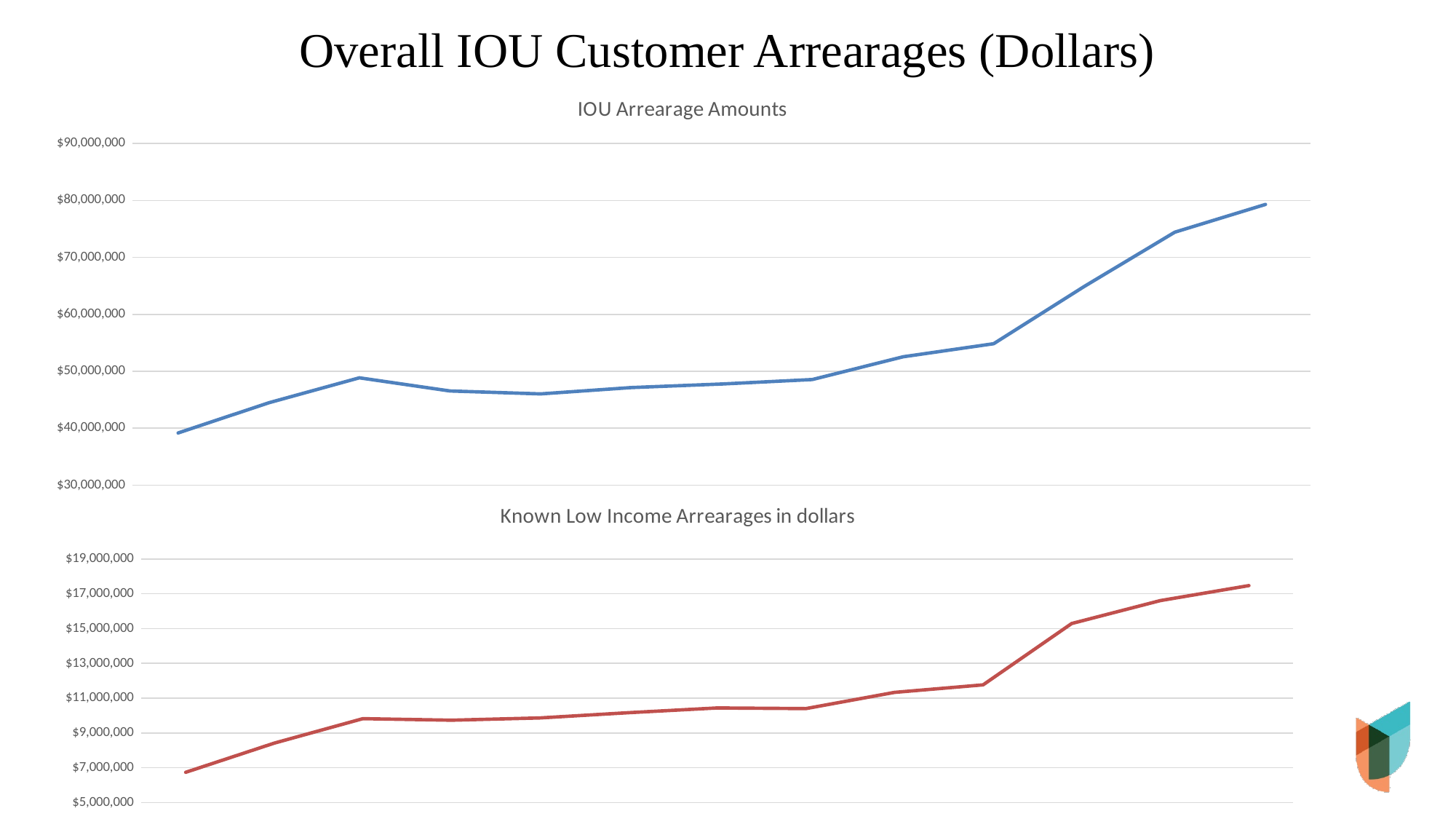
In the 'Known Low Income Arrearages in dollars' chart, is the last (rightmost) value greater or less than $17,000,000? greater In the 'IOU Arrearage Amounts' chart, is the highest point at the left end or the right end of the line? right end In the 'IOU Arrearage Amounts' chart, do the values overall rise or fall from left to right? rise In the 'IOU Arrearage Amounts' chart, is the last (rightmost) value greater or less than $70,000,000? greater What colour is the line in the 'Known Low Income Arrearages in dollars' chart? red In the 'IOU Arrearage Amounts' chart, is the first (leftmost) value greater or less than $40,000,000? less What kind of chart is the 'IOU Arrearage Amounts' chart? line chart What kind of chart is the 'Known Low Income Arrearages in dollars' chart? line chart In the 'Known Low Income Arrearages in dollars' chart, is the lowest point at the left end or the right end of the line? left end In the 'Known Low Income Arrearages in dollars' chart, do the values overall rise or fall from left to right? rise